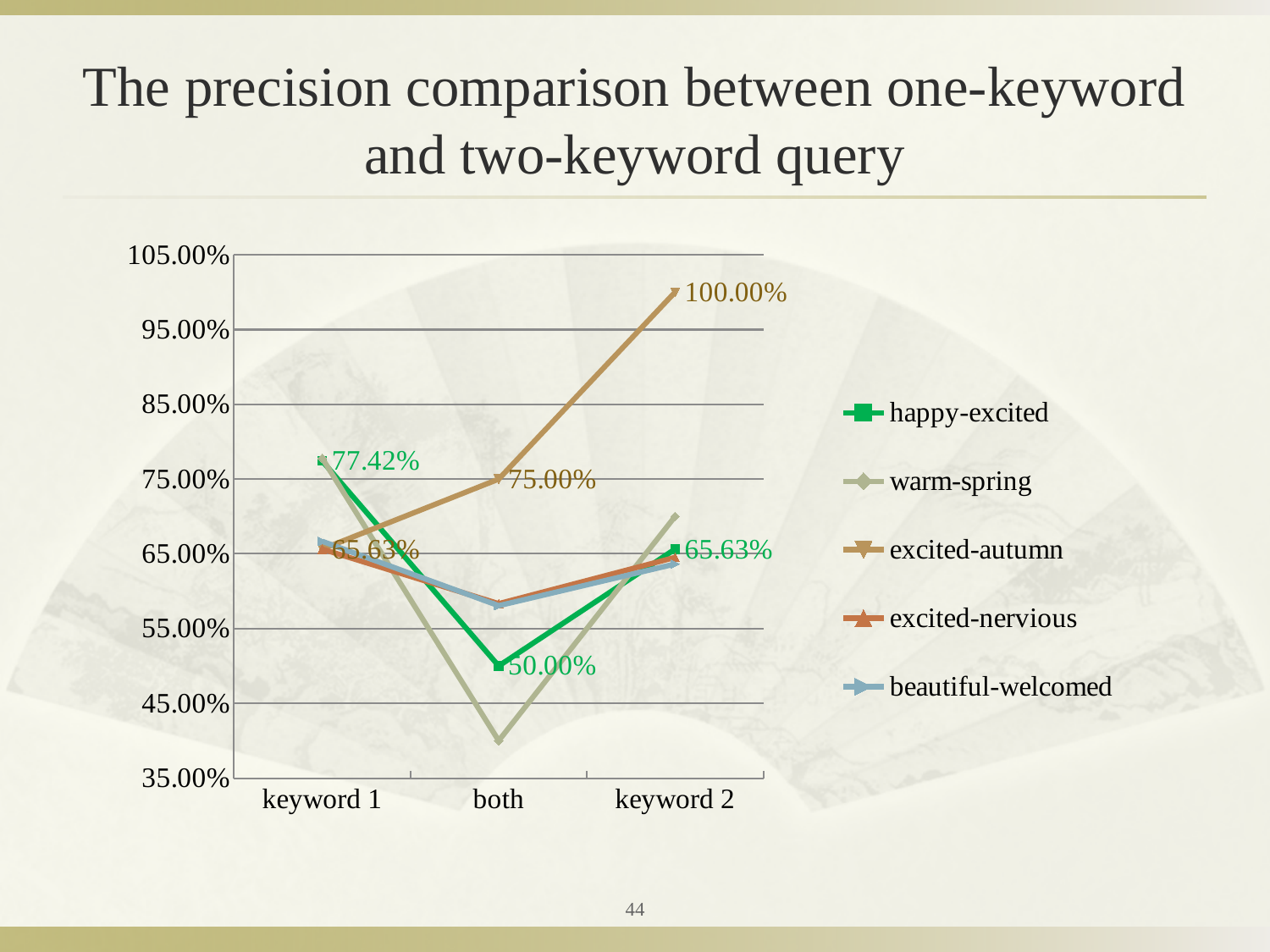
Does the excited-autumn line rise or fall from "keyword 1" to "keyword 2"? rise How many series does the legend list? 5 How much higher is excited-autumn at "keyword 2" than at "both"? 25.00% What is the precision for excited-autumn at "both"? 75.00% What is the precision for excited-autumn at "keyword 2"? 100.00% What is the precision for happy-excited at "keyword 1"? 77.42% What kind of chart is shown on the slide? line chart What is the precision for happy-excited at "both"? 50.00% Which series has the lowest value at "both"? warm-spring Is the value for warm-spring at "both" greater or less than 45.00%? less Which series has the highest value at "keyword 2"? excited-autumn How many categories are on the x axis? 3